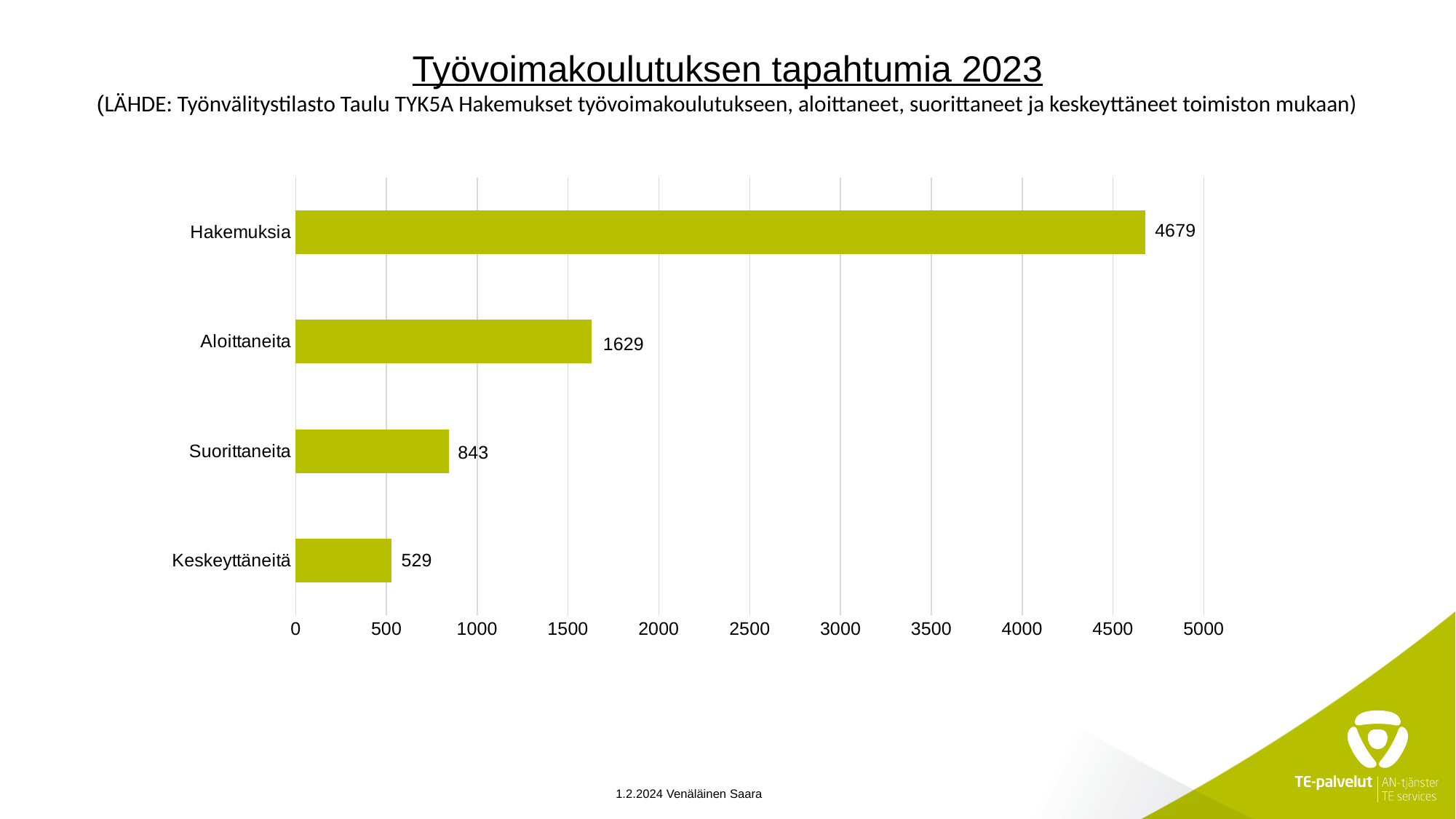
What is the value for Aloittaneita? 1629 What is the value for Hakemuksia? 4679 How many categories are shown in the chart? 4 Which category has the lowest value? Keskeyttäneitä What is the value for Suorittaneita? 843 Is the value for Aloittaneita greater or less than 1500? greater Which category has the highest value? Hakemuksia What is the difference between the values for Hakemuksia and Aloittaneita? 3050 What is the value for Keskeyttäneitä? 529 What kind of chart is shown on the slide? bar chart What is the difference between the values for Suorittaneita and Keskeyttäneitä? 314 Which is larger, the value for Aloittaneita or the value for Suorittaneita? Aloittaneita